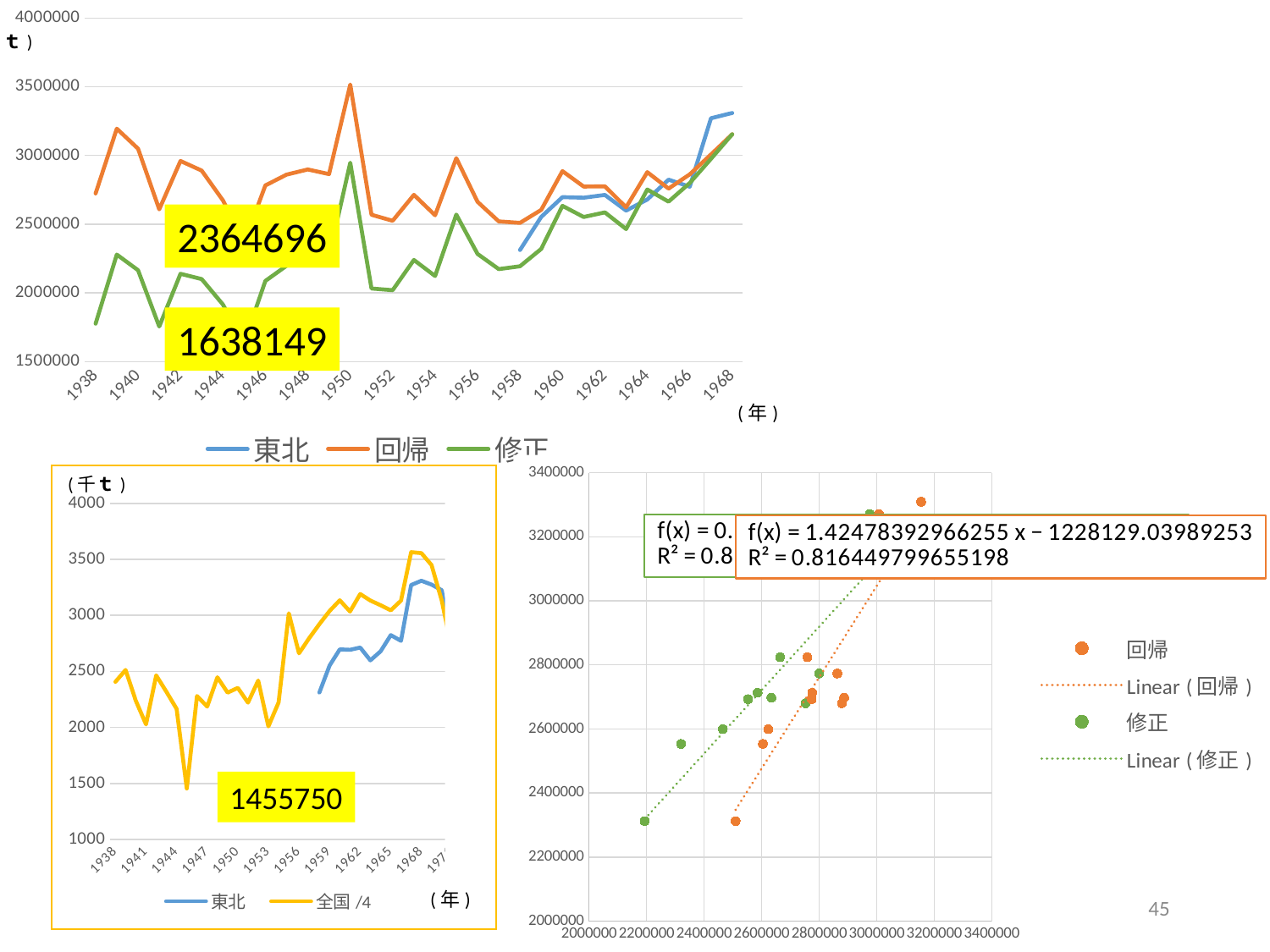
How many series does the legend of the top chart list? 3 In the bottom-left chart, is the value of 全国/4 in 1947 greater or less than 1500? greater In the bottom-right scatter chart, what colour are the 修正 points? green What kind of chart is the top chart on the slide? line chart In the top chart, does the 東北 series rise or fall from 1958 to 1968? rise How many series does the legend of the bottom-left chart list? 2 What kind of chart is the bottom-right chart on the slide? scatter chart In the top chart, is the value of 修正 in 1938 greater or less than 2000000? less In the bottom-right scatter chart, what is the R² value shown in the orange-bordered box for the 回帰 trendline? 0.816449799655198 In the top chart, which series has the highest value in 1950? 回帰 In the top chart, is the value of 回帰 in 1938 greater or less than 2500000? greater What kind of chart is the bottom-left chart on the slide? line chart